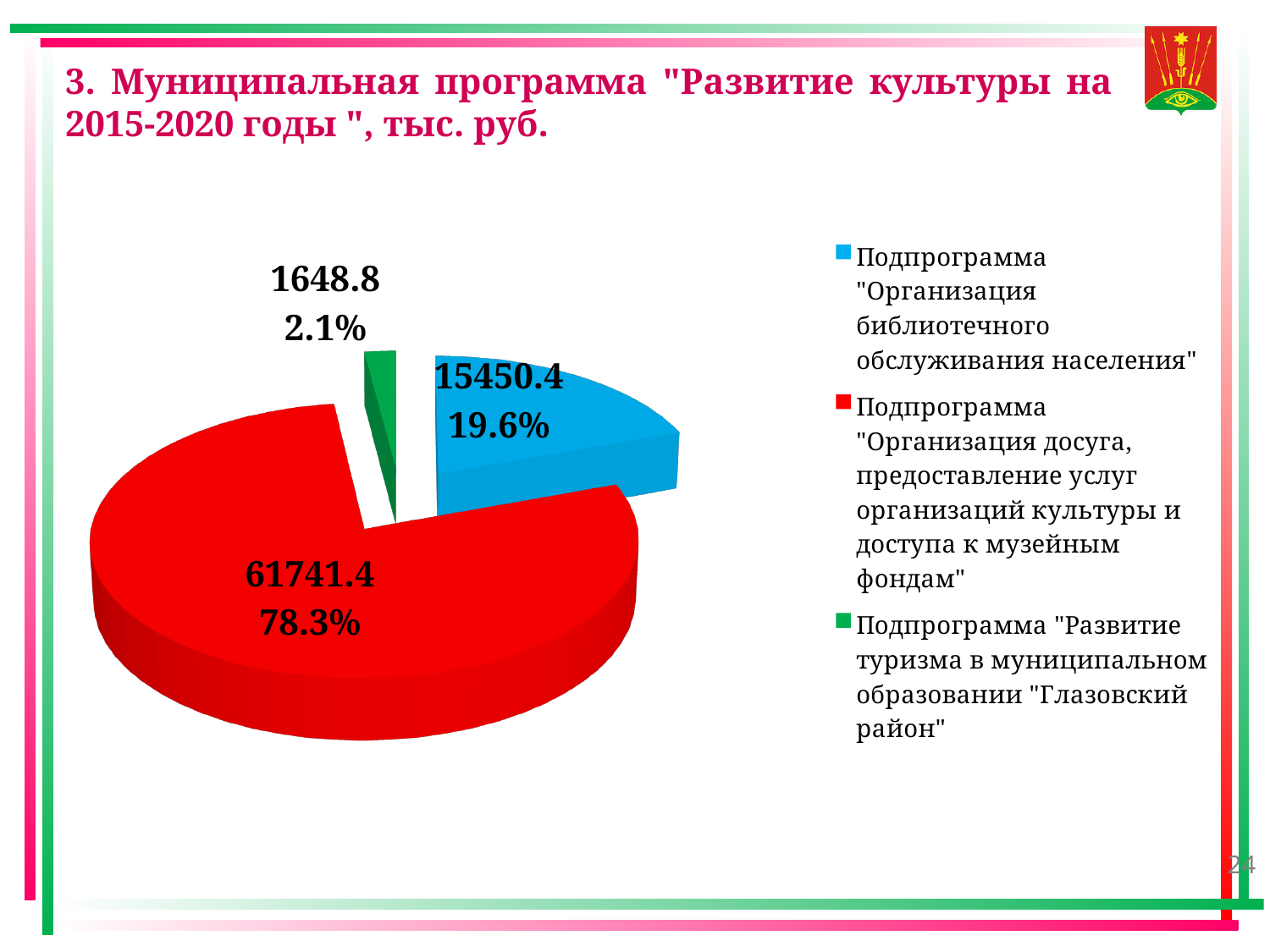
How many entries does the legend list? 3 Which colour represents the subprogram "Организация библиотечного обслуживания населения" in the pie chart? Blue Which subprogram has the largest slice of the pie? Подпрограмма "Организация досуга, предоставление услуг организаций культуры и доступа к музейным фондам" What share of the pie does the subprogram "Развитие туризма в муниципальном образовании "Глазовский район"" represent? 2.1% What is the difference between the value for "Организация досуга, предоставление услуг организаций культуры и доступа к музейным фондам" and the value for "Организация библиотечного обслуживания населения"? 46291.0 What is the value for the subprogram "Организация библиотечного обслуживания населения"? 15450.4 How many slices does the pie chart have? 3 What type of chart is shown on the slide? Pie chart What is the value for the subprogram "Организация досуга, предоставление услуг организаций культуры и доступа к музейным фондам"? 61741.4 What is the value for the subprogram "Развитие туризма в муниципальном образовании "Глазовский район""? 1648.8 Which subprogram has the smallest slice of the pie? Подпрограмма "Развитие туризма в муниципальном образовании "Глазовский район"" What share of the pie does the subprogram "Организация досуга, предоставление услуг организаций культуры и доступа к музейным фондам" represent? 78.3%